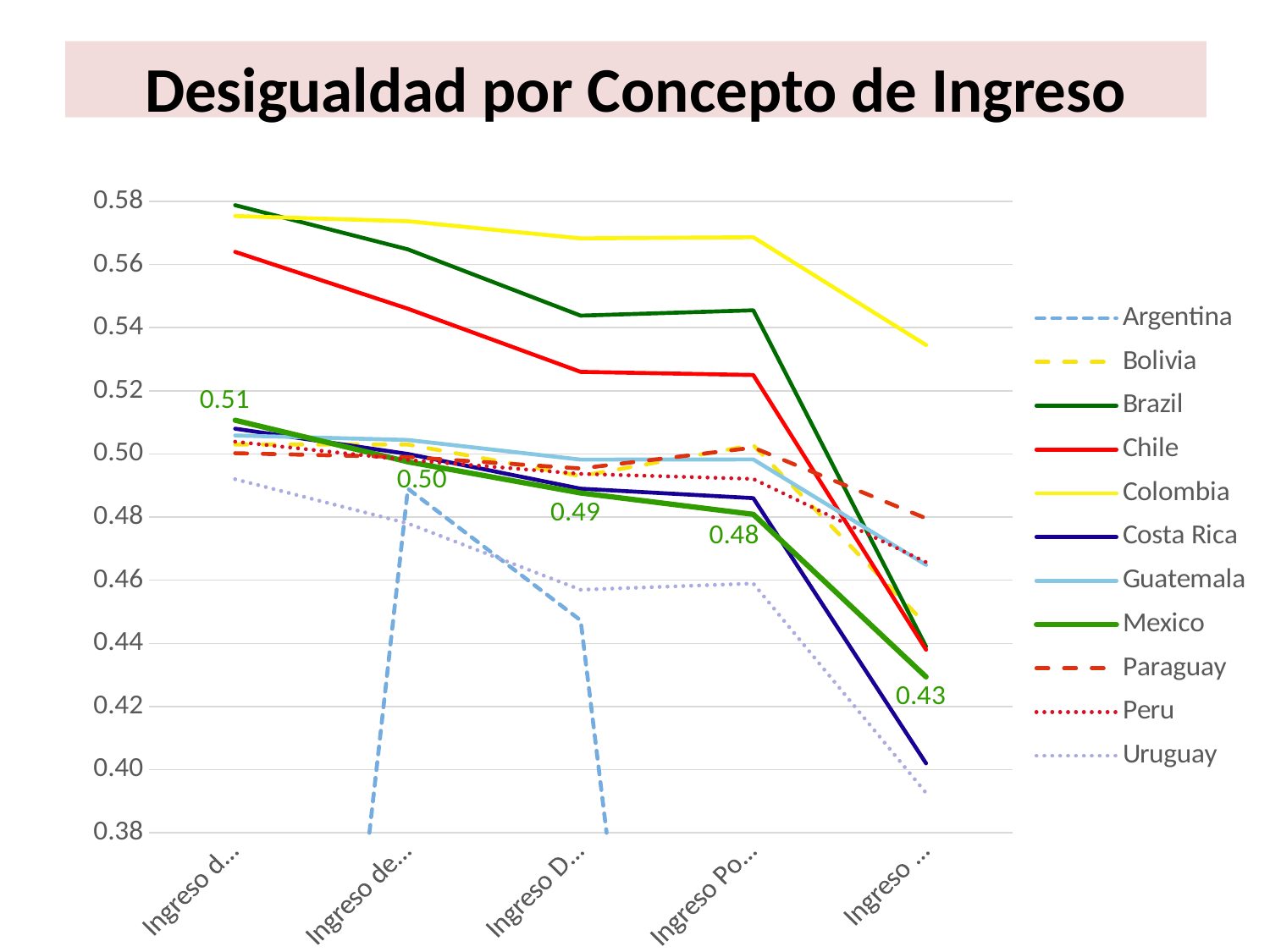
Which series has the lowest value at the last x-axis category? Uruguay How many series does the legend list? 11 How many categories are shown along the x axis? 5 What is the difference between Mexico's value at the first category and its value at the last category? 0.08 Which series has the highest value at the last x-axis category? Colombia What kind of chart is shown on the slide? line chart What is the labelled value for Mexico at the first x-axis category? 0.51 What is the title of the chart? Desigualdad por Concepto de Ingreso What is the labelled value for Mexico at the third x-axis category? 0.49 Is the value for Colombia at the first x-axis category greater or less than 0.56? greater What is the labelled value for Mexico at the last x-axis category? 0.43 Do the values for Mexico rise or fall from the first category to the last? fall